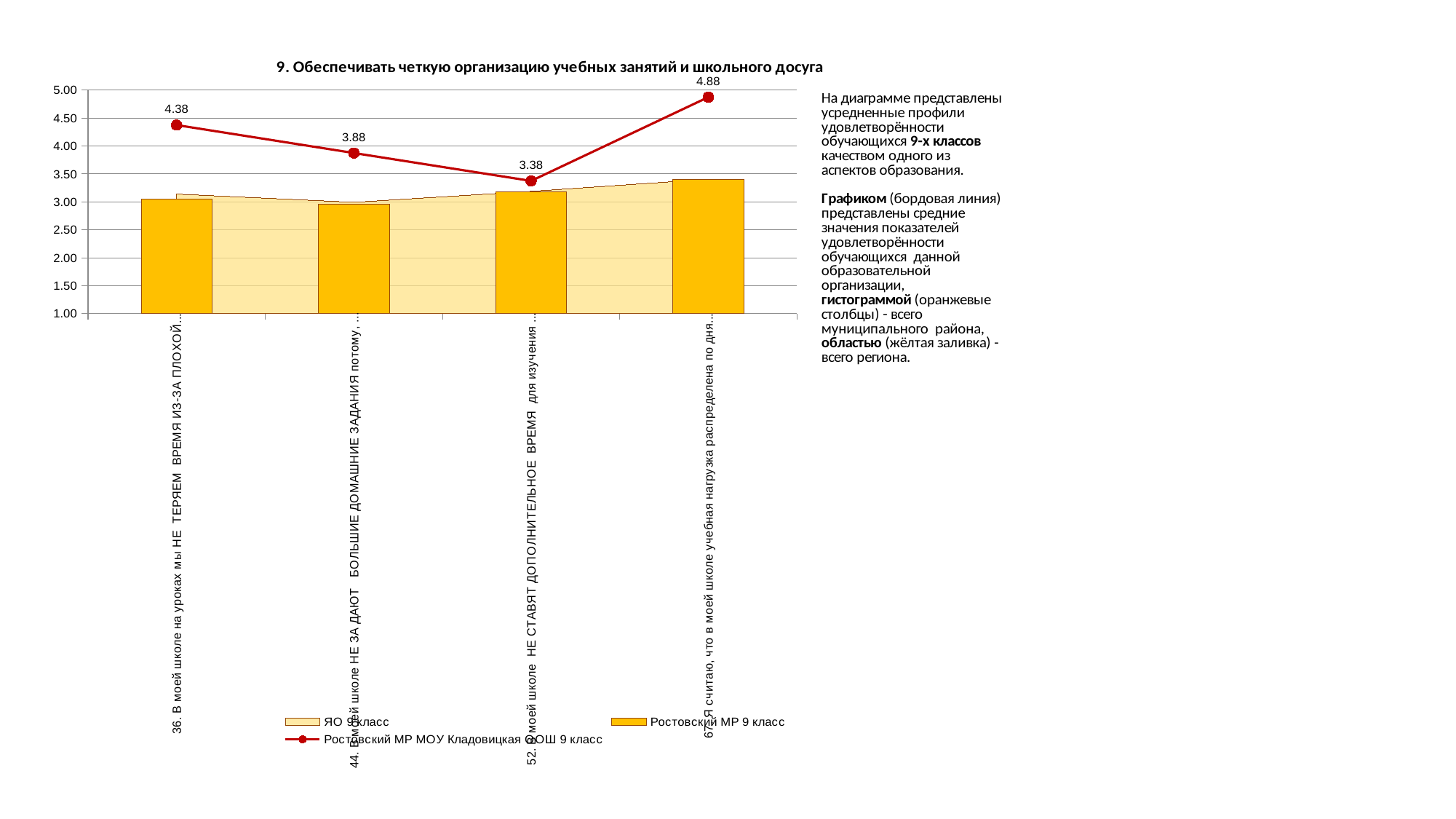
For which item does the red line (Ростовский МР МОУ Кладовицкая ООШ 9 класс) have its lowest value? 52 How many items (categories) are shown on the x axis of the chart? 4 How many series does the chart legend list? 3 For which item does the red line (Ростовский МР МОУ Кладовицкая ООШ 9 класс) reach its highest value? 67 Is the orange bar (Ростовский МР 9 класс) for item 67 greater or less than 3.00? greater What is the difference between the red line values for item 36 and item 44? 0.50 Which has the larger red line value, item 36 or item 44? 36 What is the value of the red line (Ростовский МР МОУ Кладовицкая ООШ 9 класс) for item 36? 4.38 Is the orange bar (Ростовский МР 9 класс) for item 52 greater or less than 3.00? greater What is the value of the red line (Ростовский МР МОУ Кладовицкая ООШ 9 класс) for item 67? 4.88 What is the value of the red line (Ростовский МР МОУ Кладовицкая ООШ 9 класс) for item 52? 3.38 What is the difference between the red line values for item 67 and item 52? 1.50